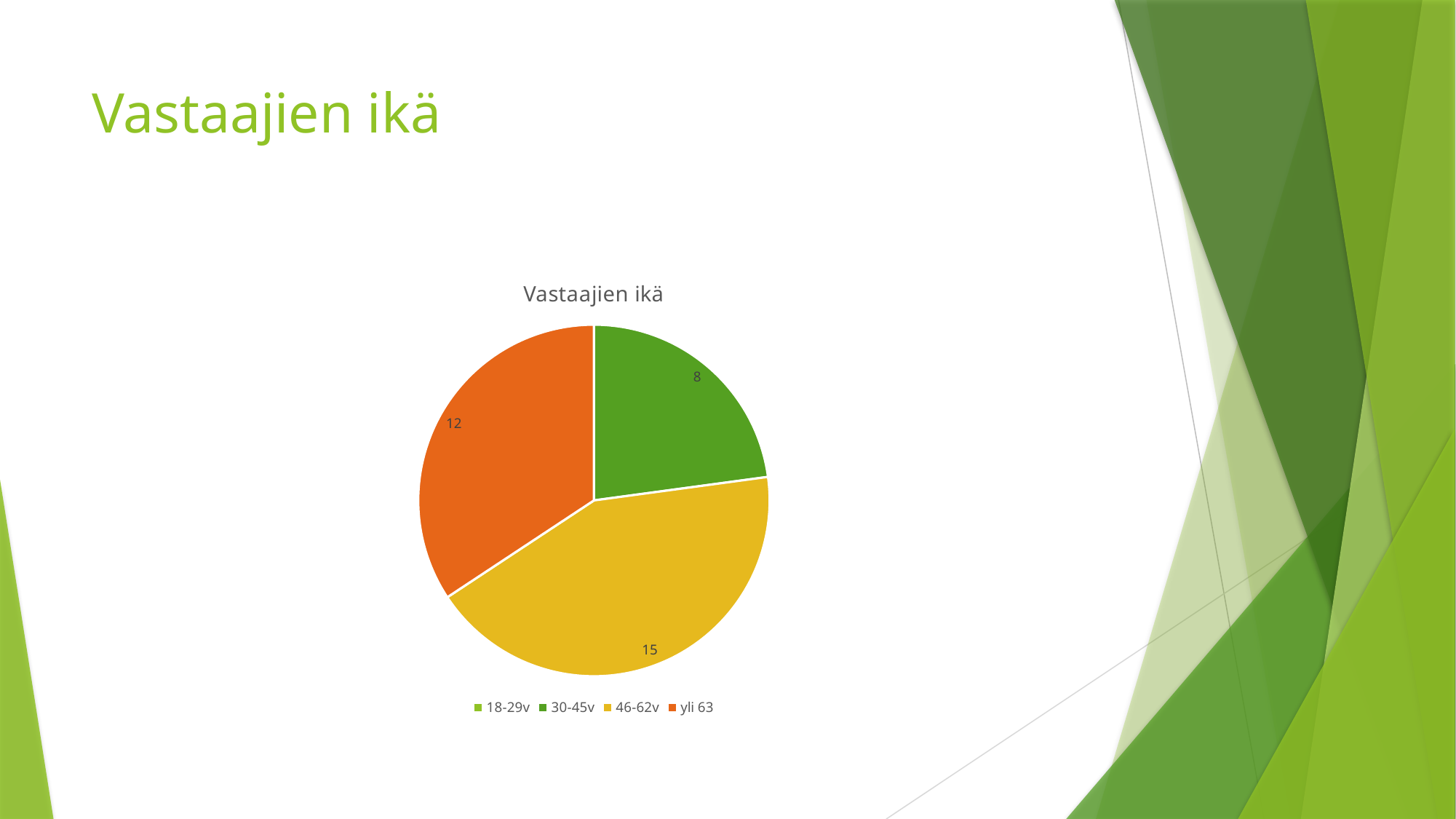
What colour is the 46-62v slice? yellow Which is larger, the 30-45v slice or the yli 63 slice? yli 63 Which is larger, the 46-62v slice or the yli 63 slice? 46-62v What is the value for the yli 63 slice? 12 What is the difference between the 46-62v value and the 30-45v value? 7 What is the difference between the yli 63 value and the 30-45v value? 4 How many entries does the chart legend list? 4 Which age group has the largest slice of the pie? 46-62v What type of chart is shown on the slide? pie chart What is the value for the 46-62v slice? 15 What is the title of the chart? Vastaajien ikä What is the value for the 30-45v slice? 8